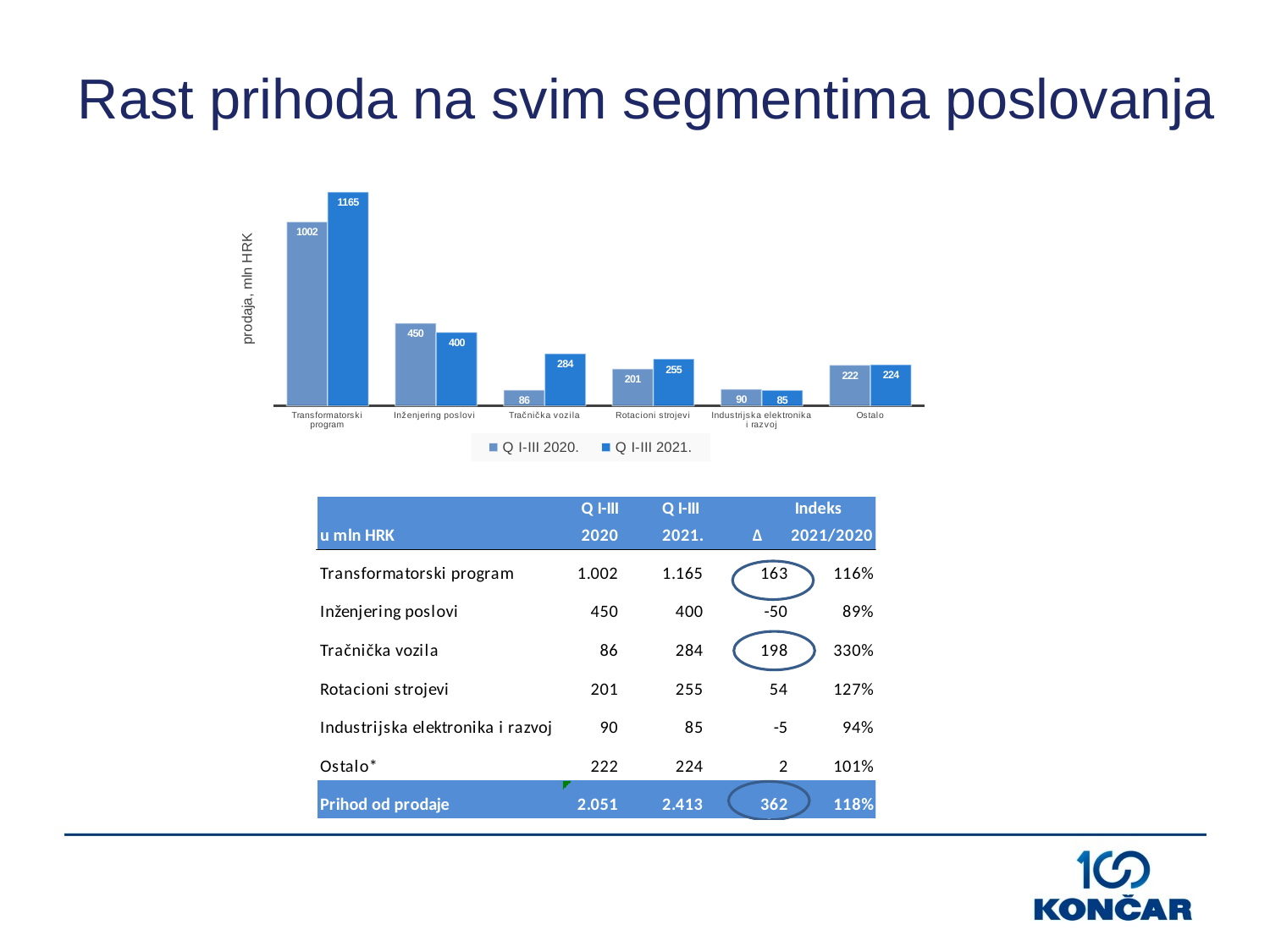
What type of chart is shown on the slide? Bar chart Which category has the lowest value in the Q I-III 2021. series? Industrijska elektronika i razvoj Which category has the highest value in the Q I-III 2020. series? Transformatorski program How many categories are shown on the x axis of the chart? 6 Which is larger for Industrijska elektronika i razvoj: the Q I-III 2020. value or the Q I-III 2021. value? Q I-III 2020. What is the label on the vertical axis of the chart? prodaja, mln HRK What is the value for Rotacioni strojevi in the Q I-III 2021. series? 255 What is the difference between the Q I-III 2021. and Q I-III 2020. values for Tračnička vozila? 198 What is the value for Transformatorski program in the Q I-III 2021. series? 1165 What is the value for Tračnička vozila in the Q I-III 2020. series? 86 What is the difference between the Q I-III 2020. and Q I-III 2021. values for Inženjering poslovi? 50 How many series does the chart legend list? 2